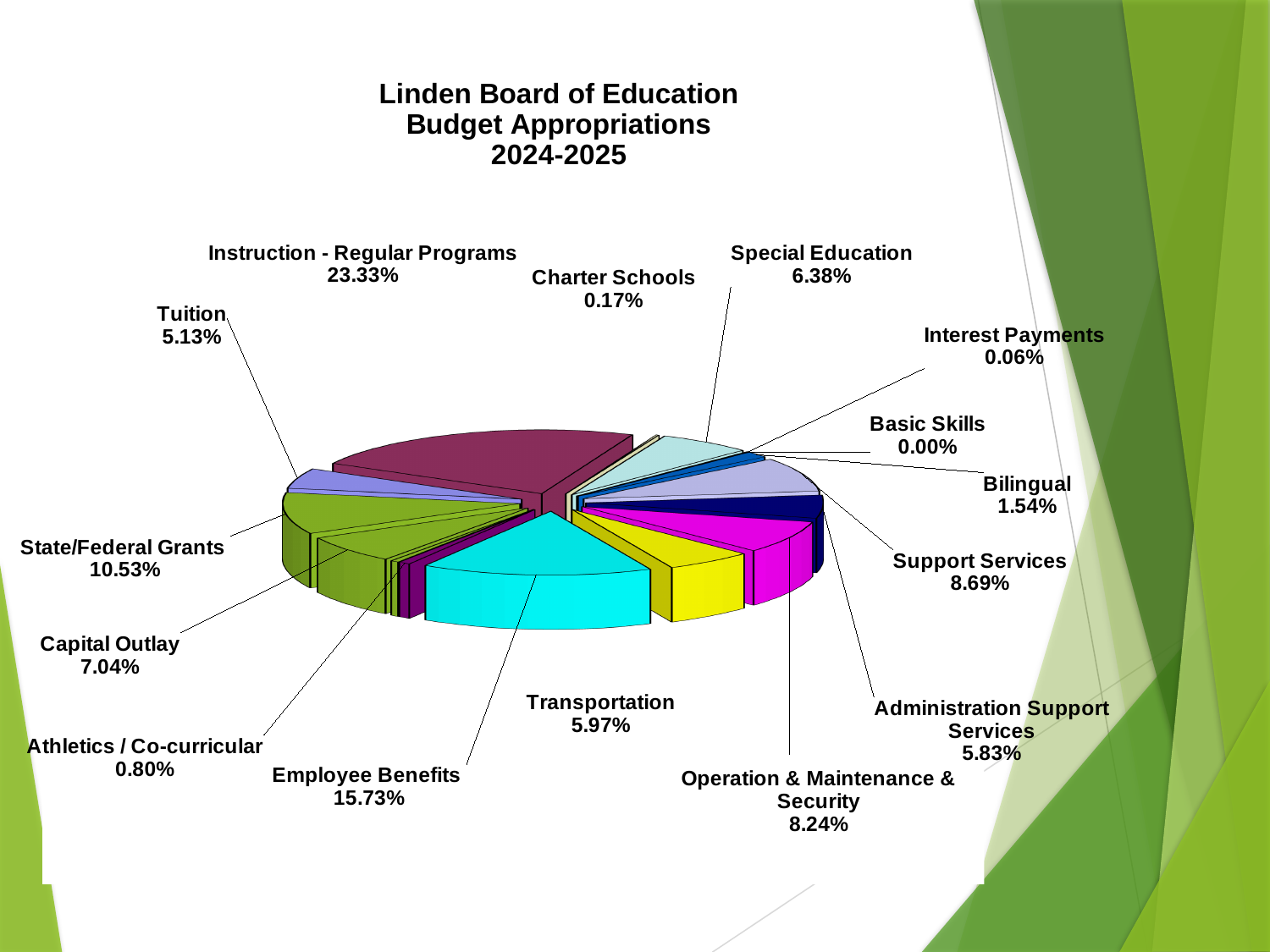
How many categories are shown in the pie chart? 15 Which is larger, the share for Support Services or the share for Operation & Maintenance & Security? Support Services What percentage is shown for Charter Schools? 0.17% What is the difference in percentage points between Capital Outlay and Tuition? 1.91 What percentage is shown for Employee Benefits? 15.73% What percentage is shown for State/Federal Grants? 10.53% Which category has the smallest share of the budget appropriations? Basic Skills What is the title of the chart? Linden Board of Education Budget Appropriations 2024-2025 What share of the budget appropriations goes to Instruction - Regular Programs? 23.33% What kind of chart is shown on the slide? Pie chart What is the difference in percentage points between Instruction - Regular Programs and Employee Benefits? 7.60 Which category has the largest share of the budget appropriations? Instruction - Regular Programs